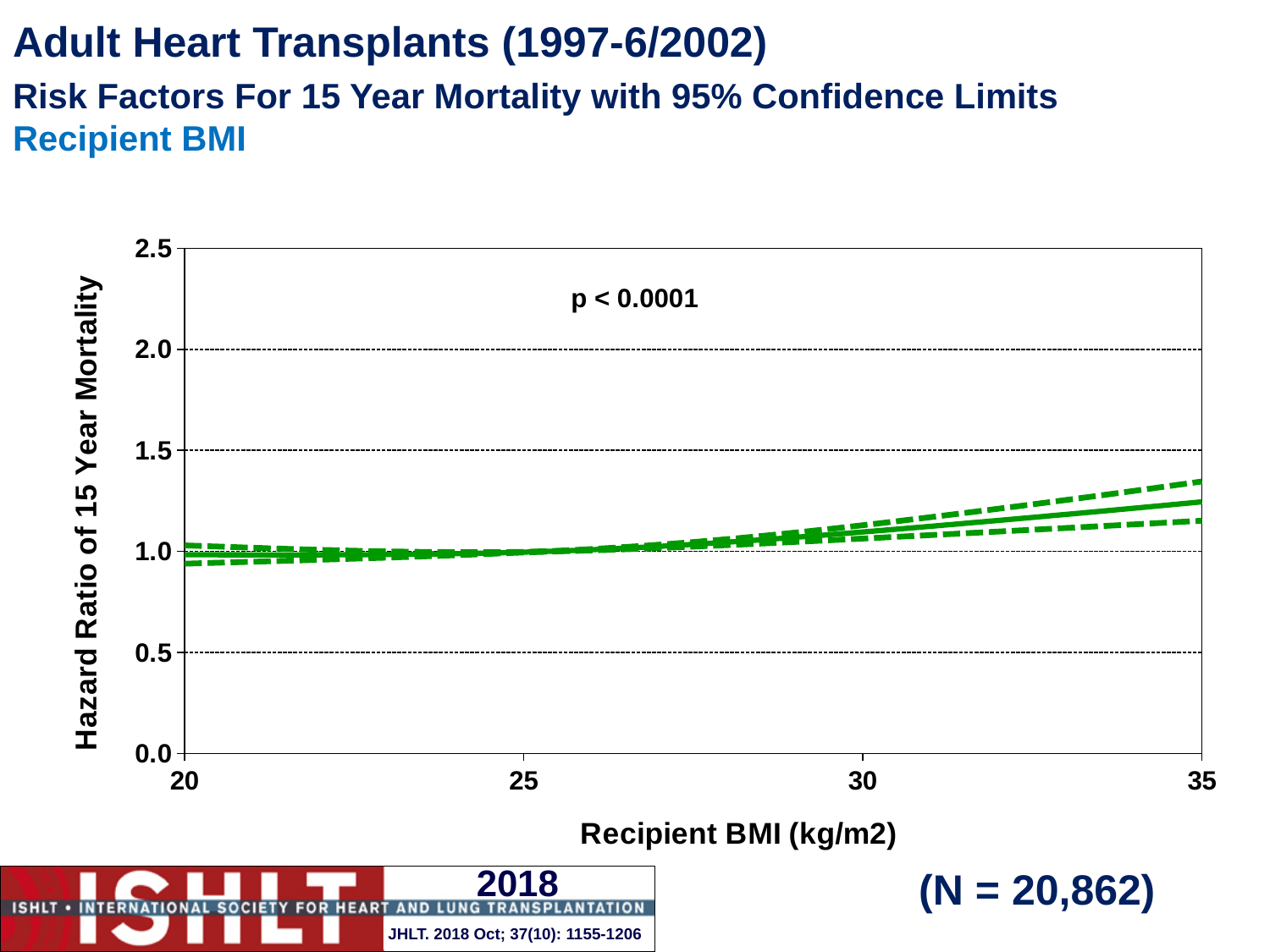
Does the hazard ratio rise or fall as recipient BMI increases from 25 to 35? rises What kind of chart is shown on the slide? line chart Is the hazard ratio for a recipient BMI of 35 greater or less than 1.5? less How many lines are plotted on the chart (solid and dashed)? 3 Is the hazard ratio for a recipient BMI of 35 greater or less than 1.0? greater What is the sample size (N) shown on the slide? N = 20,862 Is the upper 95% confidence limit at a recipient BMI of 35 greater or less than 1.5? less How many tick labels are shown on the x axis? 4 Which recipient BMI has the higher hazard ratio, 25 or 35? 35 What is the p-value printed on the chart? p < 0.0001 What is the highest value labelled on the y axis? 2.5 What is the title of the x axis? Recipient BMI (kg/m2)